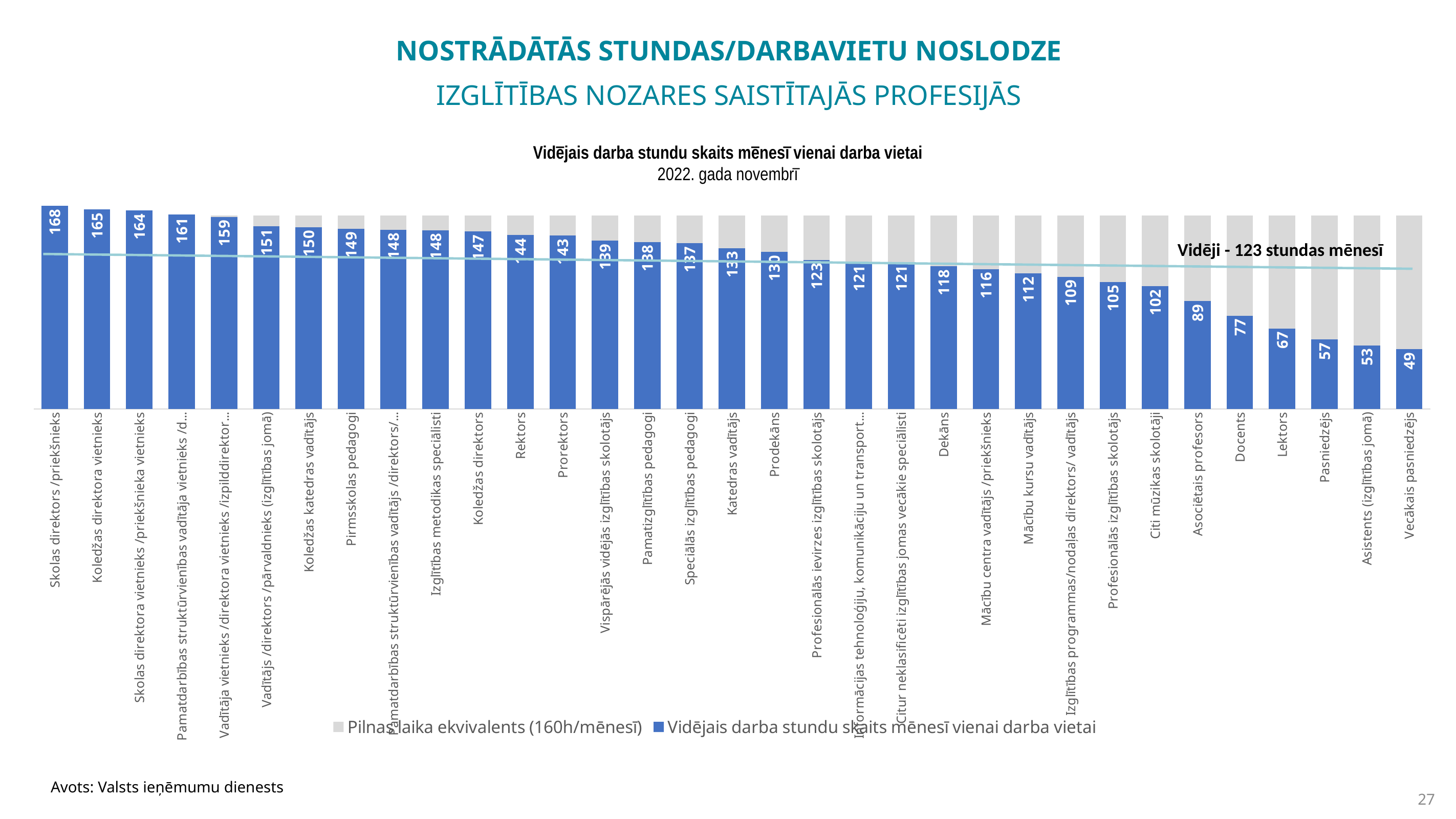
Which has a higher value, Prodekāns or Asociētais profesors? Prodekāns What overall average number of hours per month is annotated on the chart? 123 stundas mēnesī What is the difference between the values for Koledžas direktors and Lektors? 80 Which profession has the highest average number of working hours per month? Skolas direktors /priekšnieks What is the value shown for Docents? 77 What is the value shown for Dekāns? 118 What kind of chart is shown on the slide? Bar chart How many professions (categories) are shown in the chart? 33 Do the blue bar values rise or fall from left to right along the x axis? Fall How many series does the legend list? 2 What is the average number of working hours per month for Rektors? 144 Which profession has the lowest average number of working hours per month? Vecākais pasniedzējs